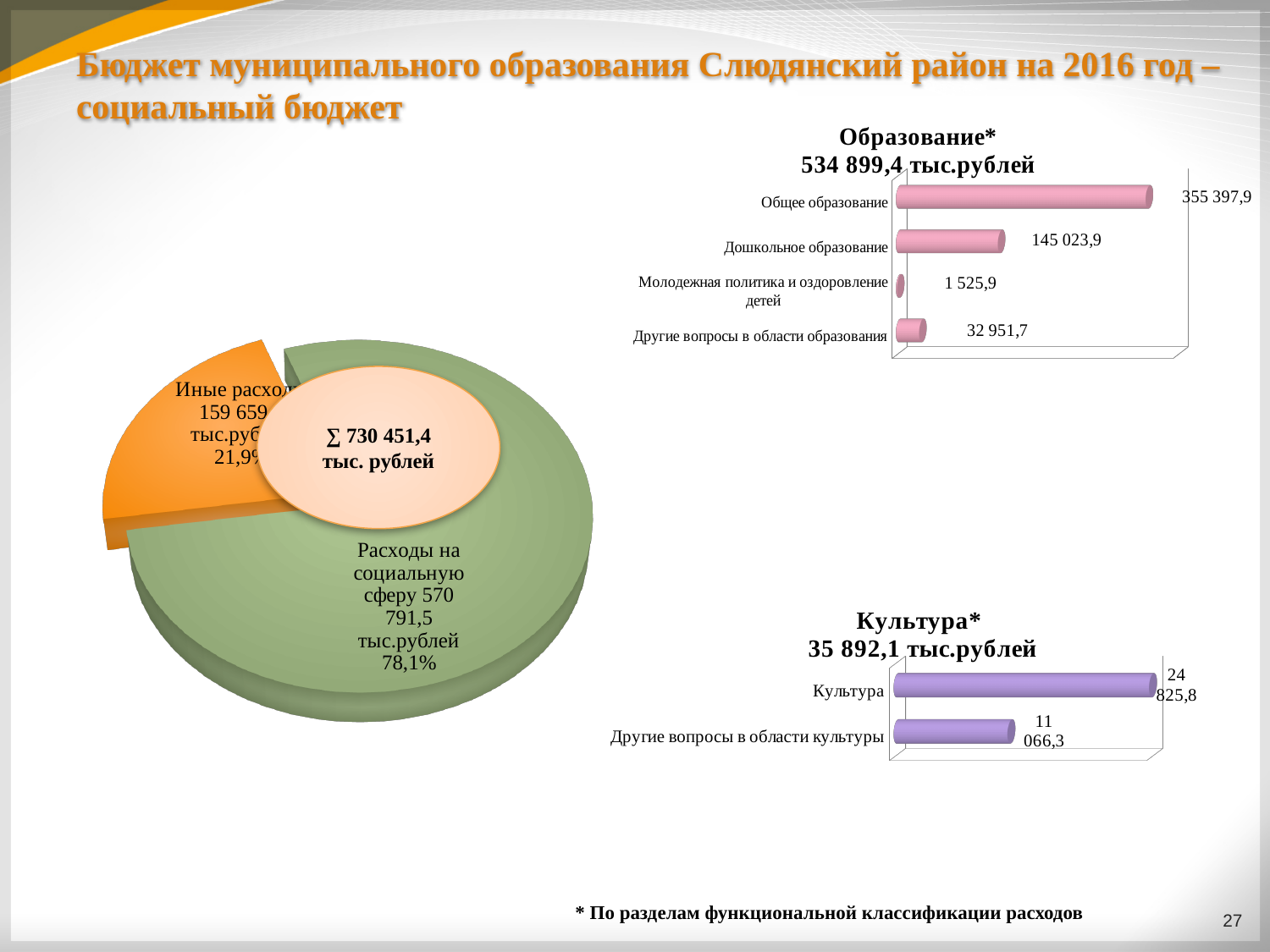
In the "Образование*" chart, how many categories are shown? 4 In the pie chart on the left, what share is shown for Расходы на социальную сферу? 78,1% In the "Образование*" chart, what is the value for Дошкольное образование? 145 023,9 In the "Культура*" chart, what is the value for Культура? 24 825,8 In the "Культура*" chart, which is larger: Культура or Другие вопросы в области культуры? Культура In the "Образование*" chart, which category has the lowest value? Молодежная политика и оздоровление детей In the "Образование*" chart, what is the difference between Общее образование and Дошкольное образование? 210 374,0 In the "Образование*" chart, what is the value for Молодежная политика и оздоровление детей? 1 525,9 In the "Культура*" chart, what is the value for Другие вопросы в области культуры? 11 066,3 In the "Образование*" chart, which category has the highest value? Общее образование What kind of chart is the chart on the left side of the slide? Pie chart In the "Образование*" chart, what is the value for Общее образование? 355 397,9